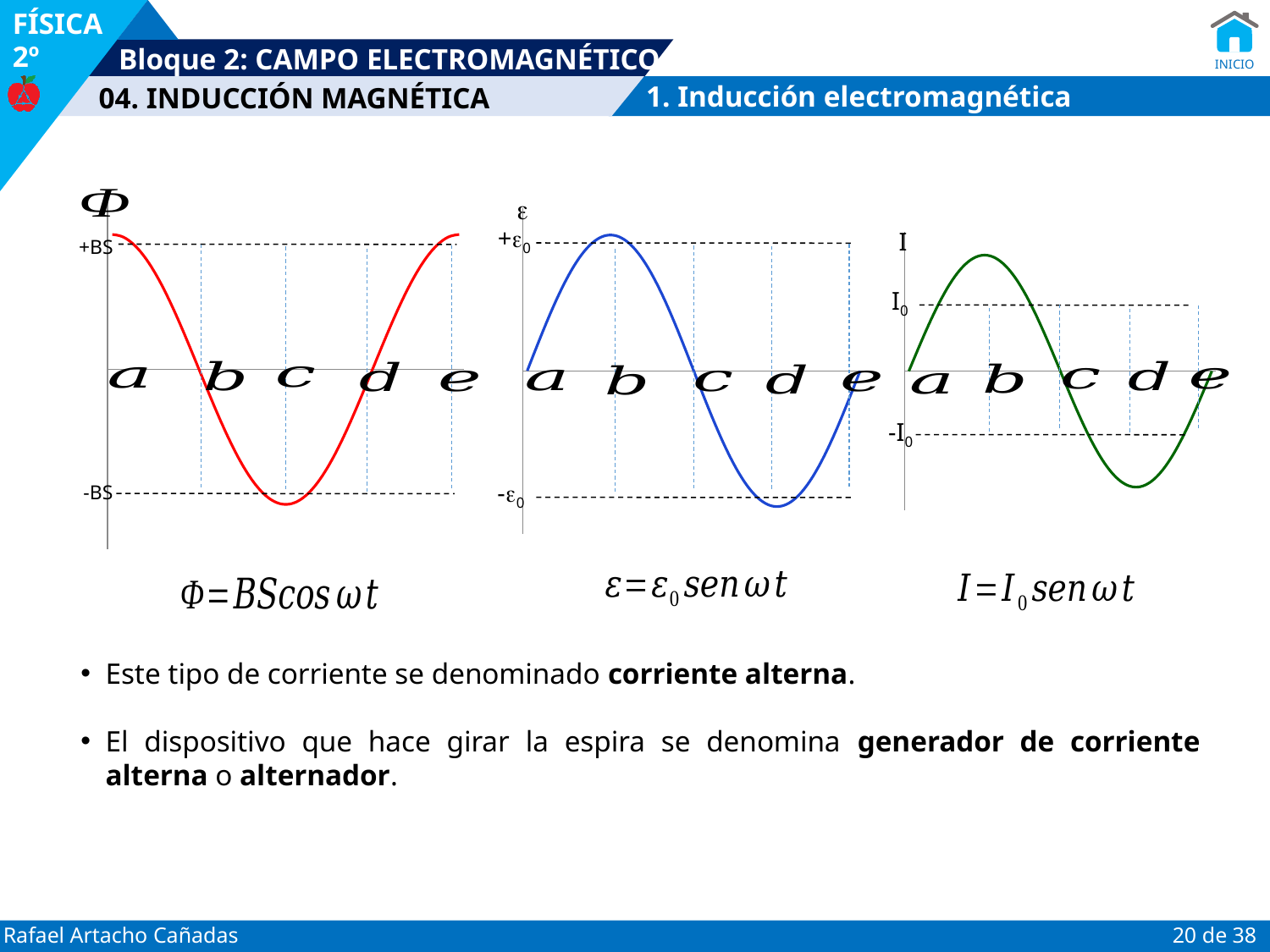
In the left-hand Φ graph, does the flux rise or fall between points a and c? fall In the right-hand I graph, at which labelled point is the current at its lowest value -I0? d What kind of chart is the left-hand graph (Φ versus time)? line chart What colour is the curve in the middle ε graph? blue In the right-hand I graph, which is larger: the current at point b or the current at point d? point b In the middle ε graph, at which labelled point does the emf reach its maximum value +ε0? b In the left-hand Φ graph, what is the value of the flux at point c? -BS In the left-hand Φ graph, does the flux rise or fall between points c and e? rise How many labelled points (a, b, c, d, e) are marked along the horizontal axis of the left-hand Φ graph? 5 In the left-hand Φ graph, what is the value of the flux at point a? +BS In the middle ε graph, does the emf rise or fall between points b and d? fall In the middle ε graph, at which labelled point does the emf reach its minimum value -ε0? d